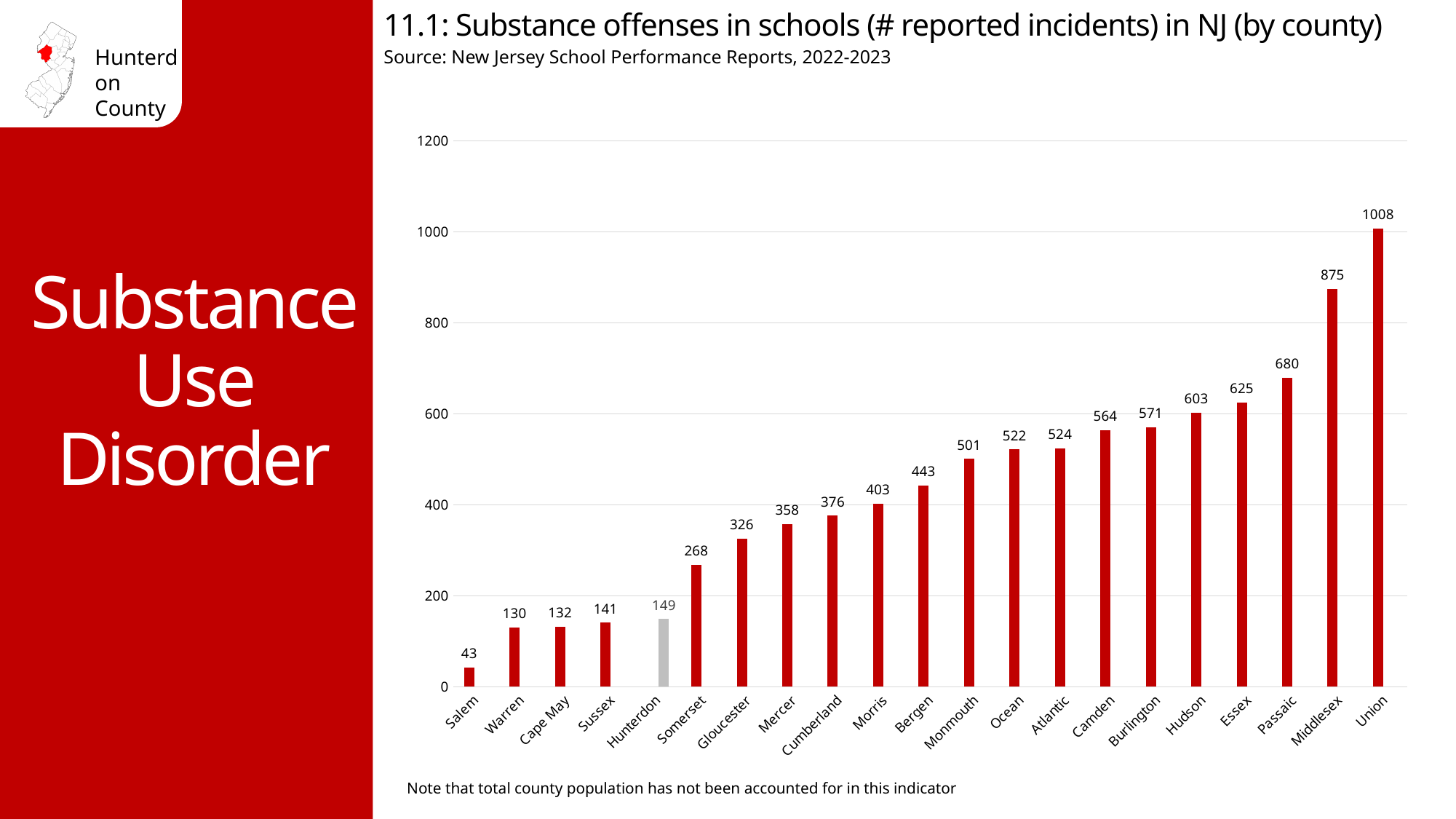
How many counties are shown on the chart? 21 What is the difference in reported incidents between Union and Middlesex? 133 What is the number of reported substance offense incidents in schools for Hunterdon County? 149 Which county has the highest number of reported substance offense incidents in schools? Union What is the difference in reported incidents between Hunterdon and Salem? 106 Which county's bar is shown in grey rather than red? Hunterdon Which county has the lowest number of reported substance offense incidents in schools? Salem What is the number of reported incidents for Middlesex County? 875 Which county has more reported incidents, Bergen or Morris? Bergen What kind of chart is used on this slide? Bar chart Do the values rise or fall moving from left to right along the x axis? Rise Is the value for Passaic greater or less than 600? greater